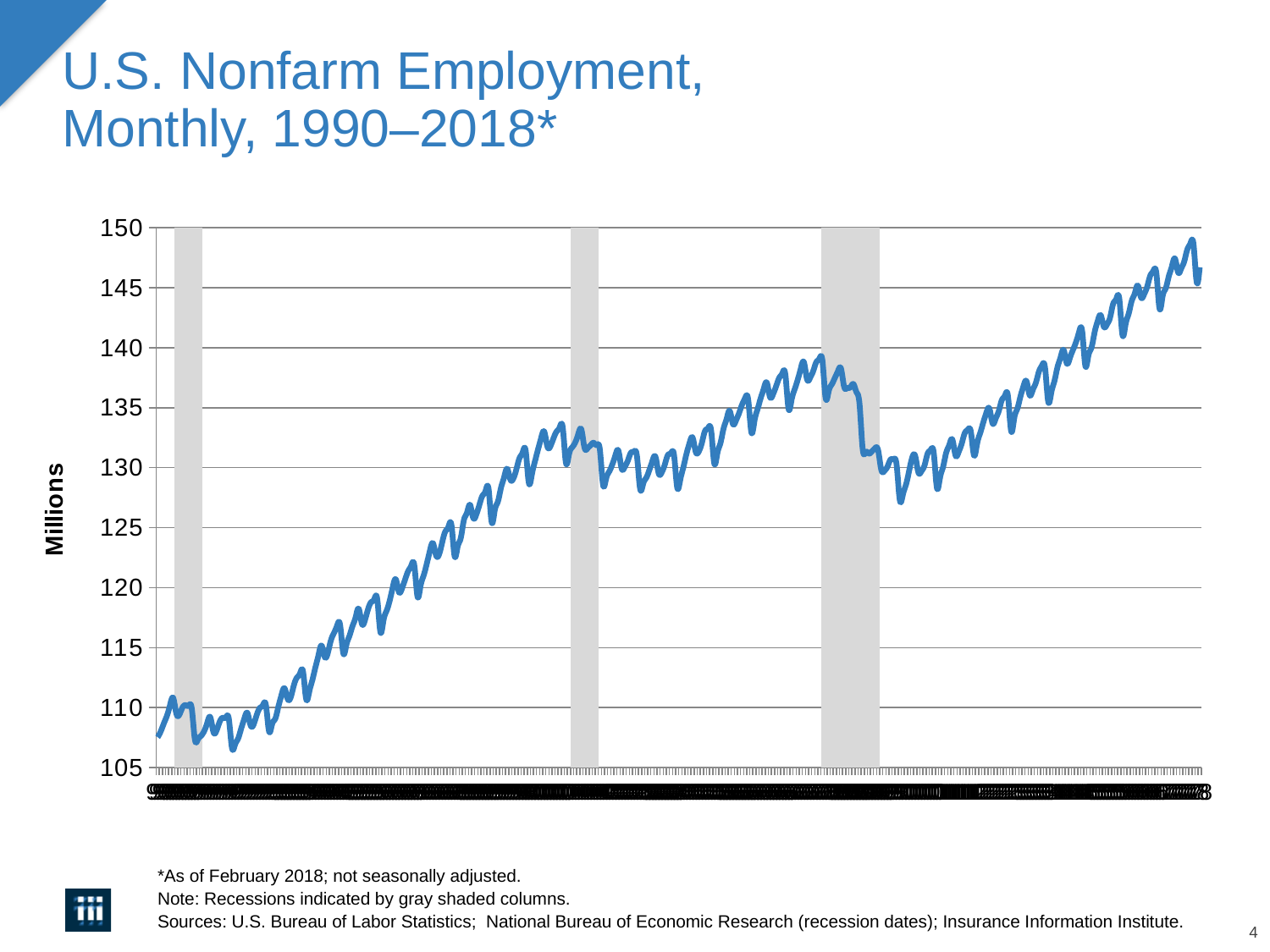
Is the highest point on the line greater or less than 145? greater What is the title of the chart? U.S. Nonfarm Employment, Monthly, 1990–2018* Overall, do the values rise or fall from 1990 to 2018? Rise What unit does the vertical axis label indicate? Millions Is the value at the end of the series (February 2018) greater or less than 145? greater Within the third (rightmost) gray shaded column, do the values rise or fall? Fall Is the value at the end of the third gray shaded column greater or less than 135? less Which is larger, the value at the start of the series or the value at the end of the series? The value at the end of the series Which is higher, the peak just before the third gray shaded column or the peak at the end of the series? The peak at the end of the series What kind of chart is shown on the slide? Line chart